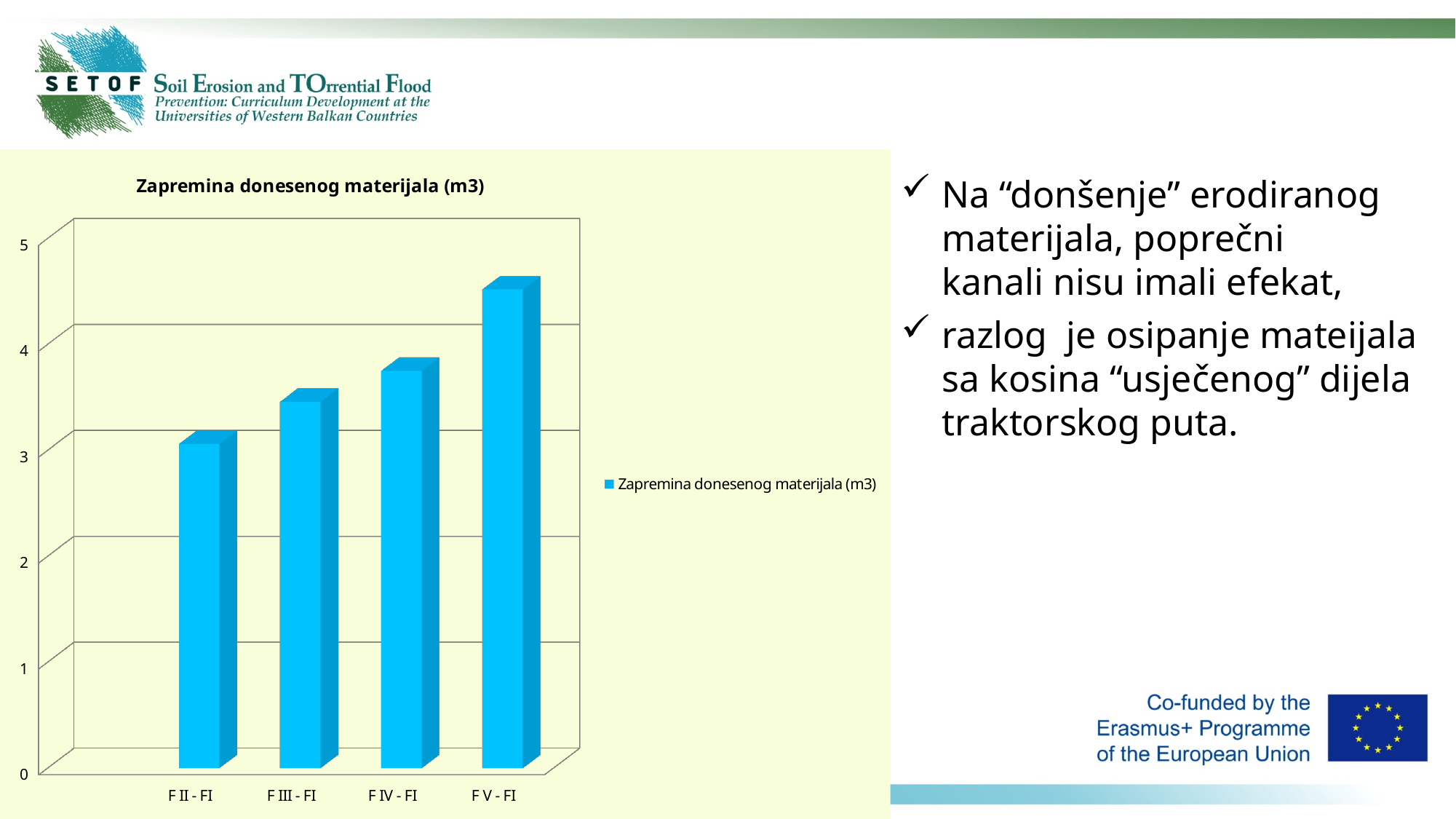
Is the value for F V - FI greater or less than 4? greater Which is larger, the value for F V - FI or the value for F II - FI? F V - FI What is the title of the chart? Zapremina donesenog materijala (m3) How many series does the chart legend list? 1 Which category has the lowest value in the chart? F II - FI Which category has the highest value in the chart? F V - FI Which is larger, the value for F IV - FI or the value for F III - FI? F IV - FI Is the value for F II - FI greater or less than 4? less What type of chart is shown on the slide? Bar chart Is the value for F IV - FI greater or less than 3? greater How many categories are shown on the x axis of the chart? 4 Do the values rise or fall from F II - FI to F V - FI along the x axis? Rise